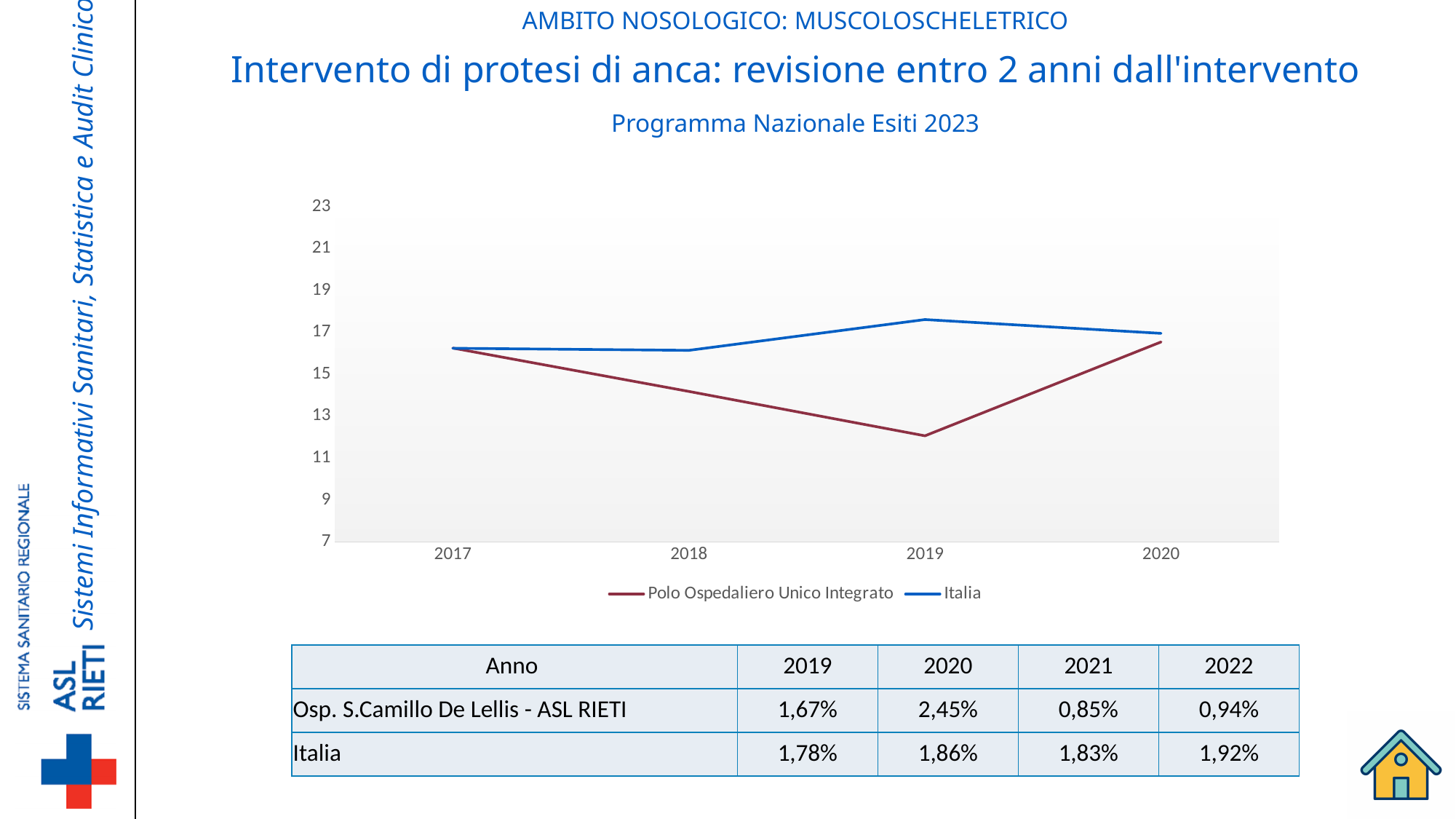
Is the value for Italia in 2018 greater or less than 17? less Does the Polo Ospedaliero Unico Integrato line rise or fall from 2017 to 2019? fall In which year does the Italia line reach its highest value? 2019 Which series is drawn in blue in the chart? Italia Is the value for Polo Ospedaliero Unico Integrato in 2018 greater or less than 15? less What kind of chart is shown on the slide? line chart Does the Italia line rise or fall from 2018 to 2019? rise Is the value for Polo Ospedaliero Unico Integrato in 2019 greater or less than 13? less In 2019, which series has the larger value, Polo Ospedaliero Unico Integrato or Italia? Italia In which year does the Polo Ospedaliero Unico Integrato line reach its lowest value? 2019 How many series does the chart legend list? 2 How many years are plotted along the x axis of the chart? 4